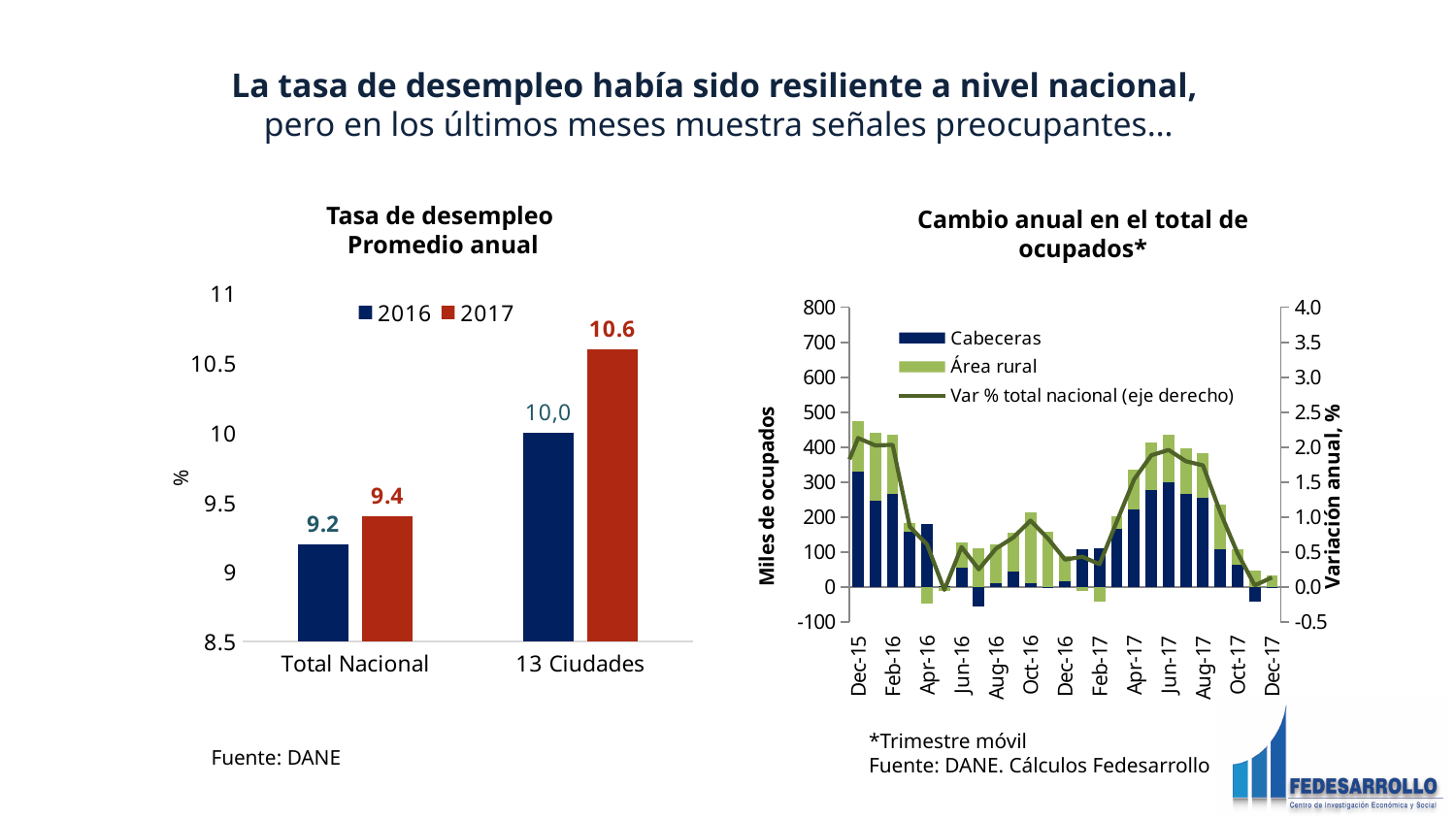
In the 'Cambio anual en el total de ocupados*' chart, is the total stacked bar for Dec-15 greater or less than 400? greater In the 'Cambio anual en el total de ocupados*' chart, is the 'Var % total nacional (eje derecho)' line value for Dec-15 greater or less than 1.5? greater How many series does the legend of the 'Cambio anual en el total de ocupados*' chart list? 3 In the 'Tasa de desempleo Promedio anual' chart, what is the 2016 value for Total Nacional? 9.2 In the 'Tasa de desempleo Promedio anual' chart, which bar is the highest? 13 Ciudades, 2017 How many series does the legend of the 'Tasa de desempleo Promedio anual' chart list? 2 In the 'Tasa de desempleo Promedio anual' chart, which is larger: the 2017 value for Total Nacional or the 2016 value for 13 Ciudades? 2016 value for 13 Ciudades In the 'Tasa de desempleo Promedio anual' chart, what is the difference between the 2017 and 2016 values for Total Nacional? 0.2 In the 'Tasa de desempleo Promedio anual' chart, what is the 2016 value for 13 Ciudades? 10,0 What kind of chart is 'Tasa de desempleo Promedio anual'? Bar chart In the 'Cambio anual en el total de ocupados*' chart, does the 'Var % total nacional (eje derecho)' line rise or fall between Feb-16 and Apr-16? fall In the 'Tasa de desempleo Promedio anual' chart, what is the 2017 value for 13 Ciudades? 10.6